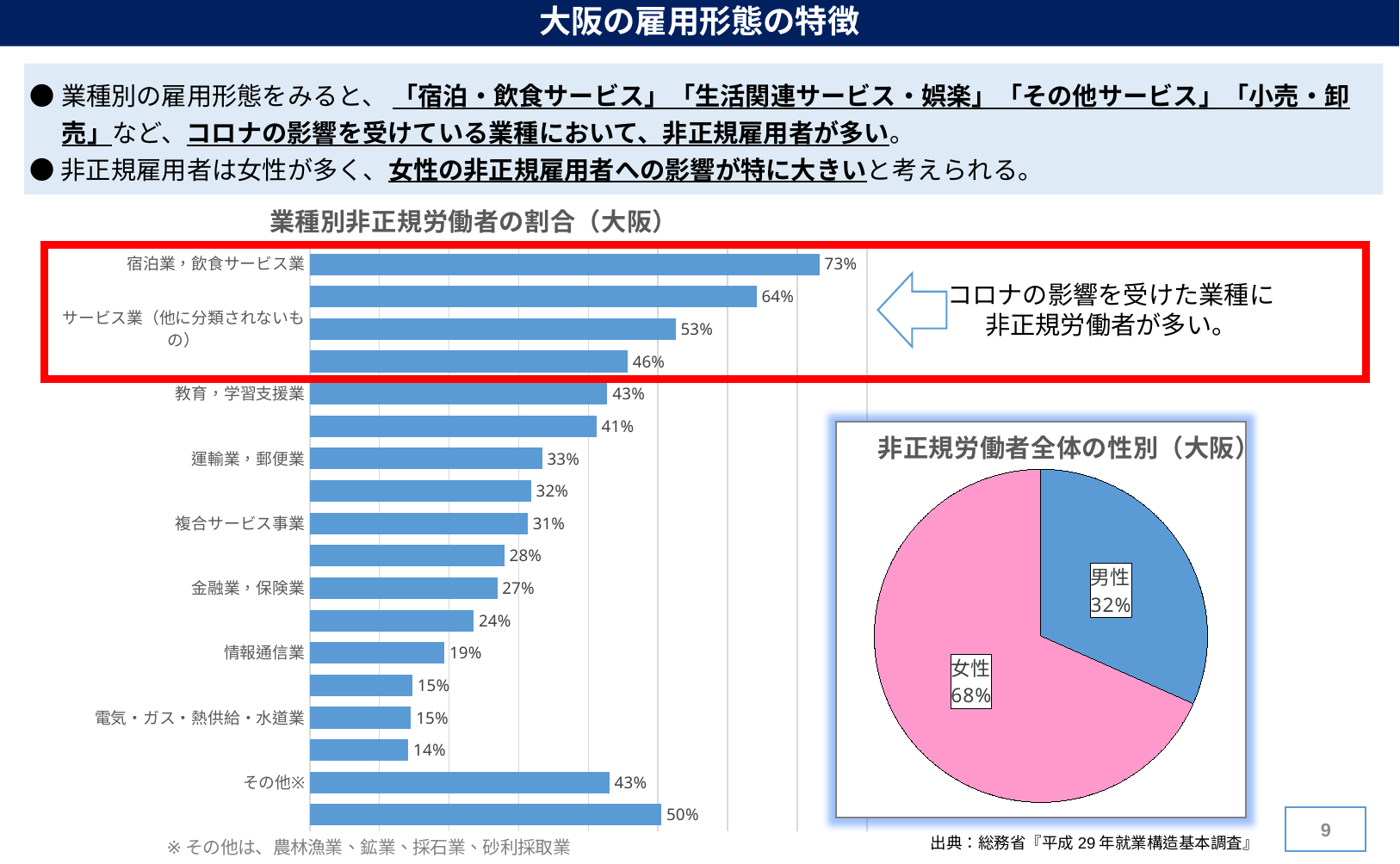
In the pie chart 非正規労働者全体の性別（大阪）, what is the difference between the 女性 and 男性 shares? 36 percentage points In the bar chart 業種別非正規労働者の割合（大阪）, which is larger: 複合サービス事業 or 電気・ガス・熱供給・水道業? 複合サービス事業 In the bar chart 業種別非正規労働者の割合（大阪）, what is the value for 金融業，保険業? 27% In the bar chart 業種別非正規労働者の割合（大阪）, what is the difference between 宿泊業，飲食サービス業 and 運輸業，郵便業? 40 percentage points In the bar chart 業種別非正規労働者の割合（大阪）, what is the value for 宿泊業，飲食サービス業? 73% In the bar chart 業種別非正規労働者の割合（大阪）, what is the value for 情報通信業? 19% What kind of chart is 非正規労働者全体の性別（大阪）? Pie chart In the bar chart 業種別非正規労働者の割合（大阪）, which labelled industry has the highest value? 宿泊業，飲食サービス業 In the pie chart 非正規労働者全体の性別（大阪）, what share is 女性? 68% In the bar chart 業種別非正規労働者の割合（大阪）, how many bars are plotted? 18 What kind of chart is 業種別非正規労働者の割合（大阪）? Bar chart In the bar chart 業種別非正規労働者の割合（大阪）, what is the value for 教育，学習支援業? 43%